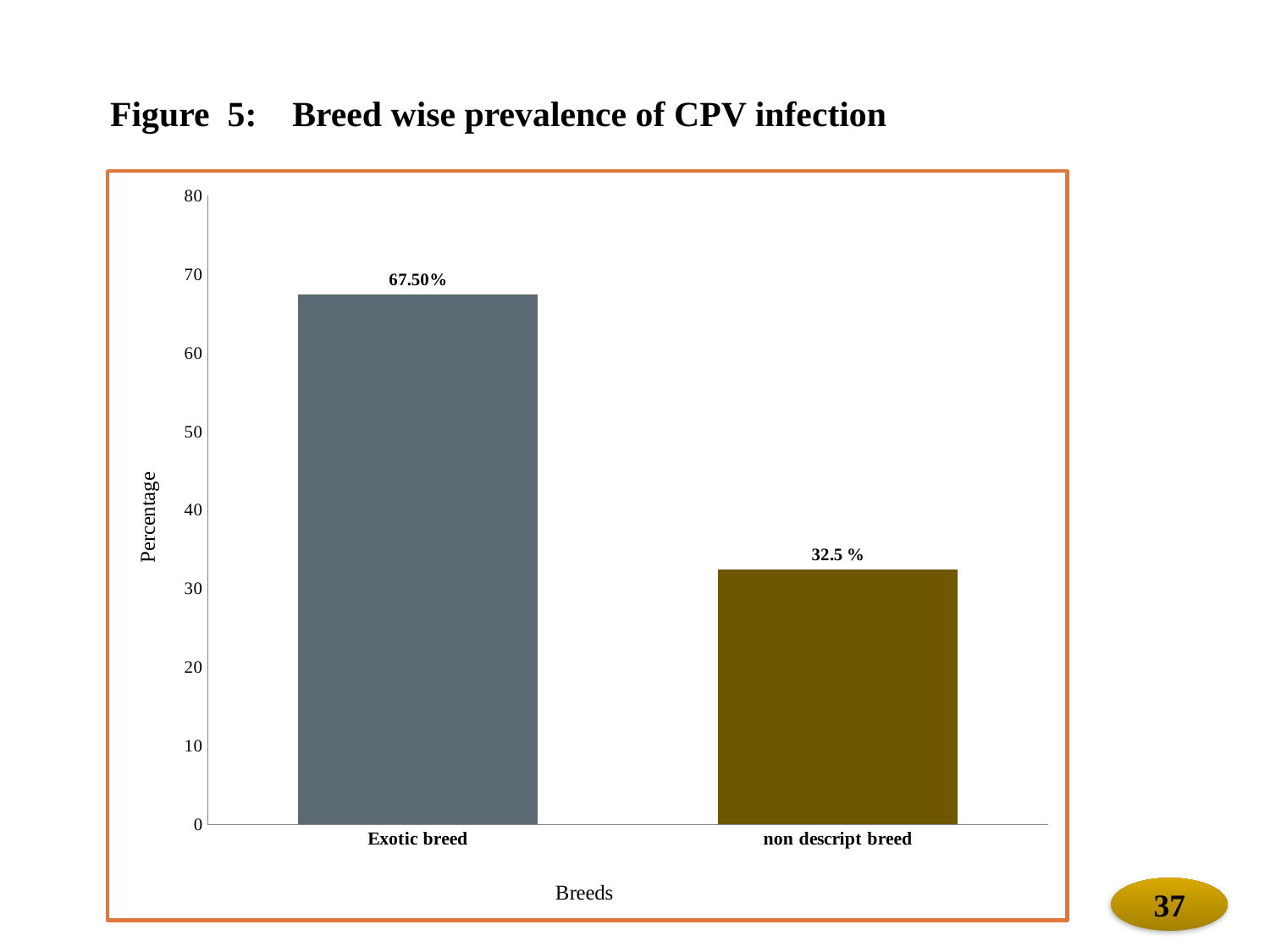
Which breed category has the highest prevalence of CPV infection? Exotic breed What is the title of the figure on the slide? Figure 5: Breed wise prevalence of CPV infection What is the prevalence value shown for non descript breed? 32.5 % Is the value for non descript breed greater or less than 40? less What is the label of the y axis? Percentage What kind of chart is shown on the slide? Bar chart Is the value for Exotic breed greater or less than 60? greater What is the difference in percentage points between the Exotic breed and non descript breed values? 35 How many breed categories are shown on the x axis? 2 Which breed category has the lowest prevalence of CPV infection? non descript breed Which is larger, the value for Exotic breed or the value for non descript breed? Exotic breed What is the prevalence value shown for Exotic breed? 67.50%